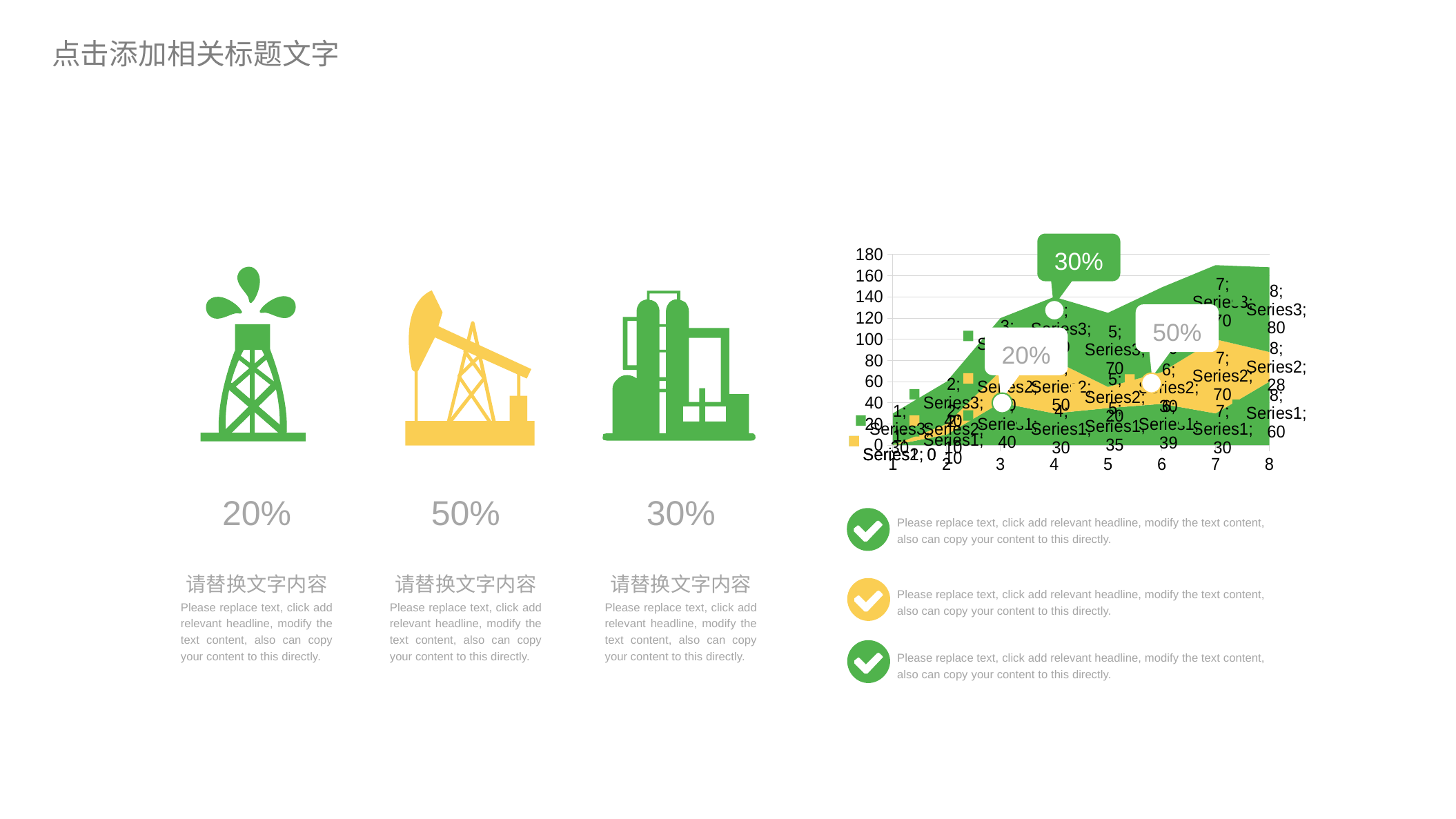
What is the value of Series1 at category 7 in the area chart? 30 What is the value of Series3 at category 5 in the area chart? 70 What percentage is shown in the topmost callout label on the area chart? 30% What is the value of Series1 at category 6 in the area chart? 39 Which is larger in the area chart: Series1 at category 8 or Series1 at category 7? Series1 at category 8 What is the value of Series1 at category 5 in the area chart? 35 What is the value of Series3 at category 8 in the area chart? 80 What is the highest value shown on the vertical axis of the area chart? 180 How many categories are shown along the x axis of the area chart? 8 What kind of chart is shown on the right side of the slide? area chart What is the value of Series1 at category 8 in the area chart? 60